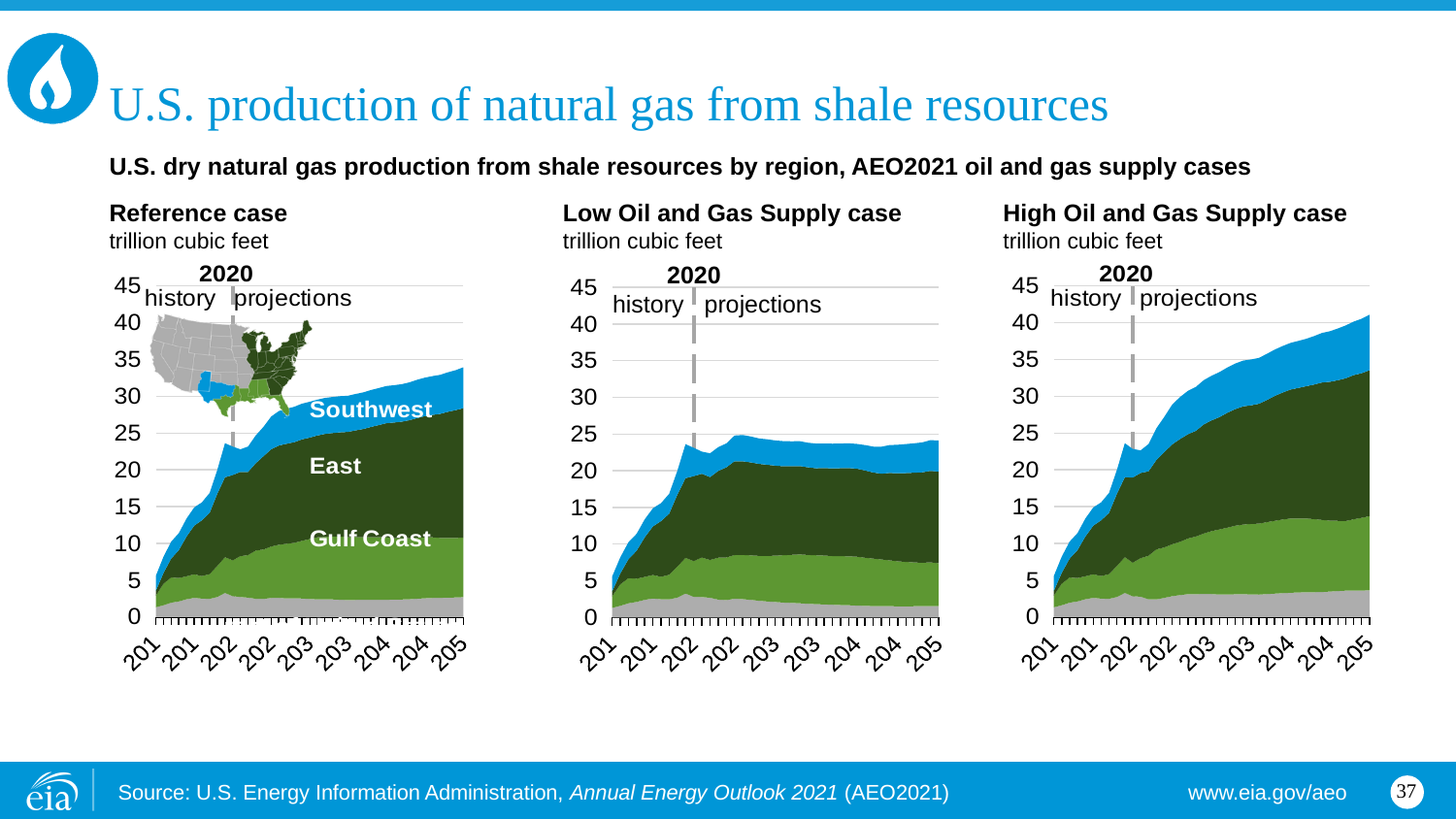
Which chart shows the higher total shale gas production at the end of the projection period, the High Oil and Gas Supply case or the Low Oil and Gas Supply case? High Oil and Gas Supply case In the Low Oil and Gas Supply case chart, is the total shale gas production at the end of the projection period greater or less than 30? less In the Reference case chart, what unit is used on the y axis? trillion cubic feet What kind of chart is the Reference case chart? stacked area chart In the Reference case chart, which labeled region contributes the most shale gas production at the end of the projection period? East In the High Oil and Gas Supply case chart, is the total shale gas production at the end of the projection period greater or less than 35? greater In the Reference case chart, which year does the dashed line separating history from projections mark? 2020 How many charts are shown on the slide? 3 In the Reference case chart, is the total shale gas production in 2020 greater or less than 20? greater In the Reference case chart, which of the labeled regions contributes the least shale gas production at the end of the projection period? Southwest In the High Oil and Gas Supply case chart, does total shale gas production rise or fall over the projection period? rise